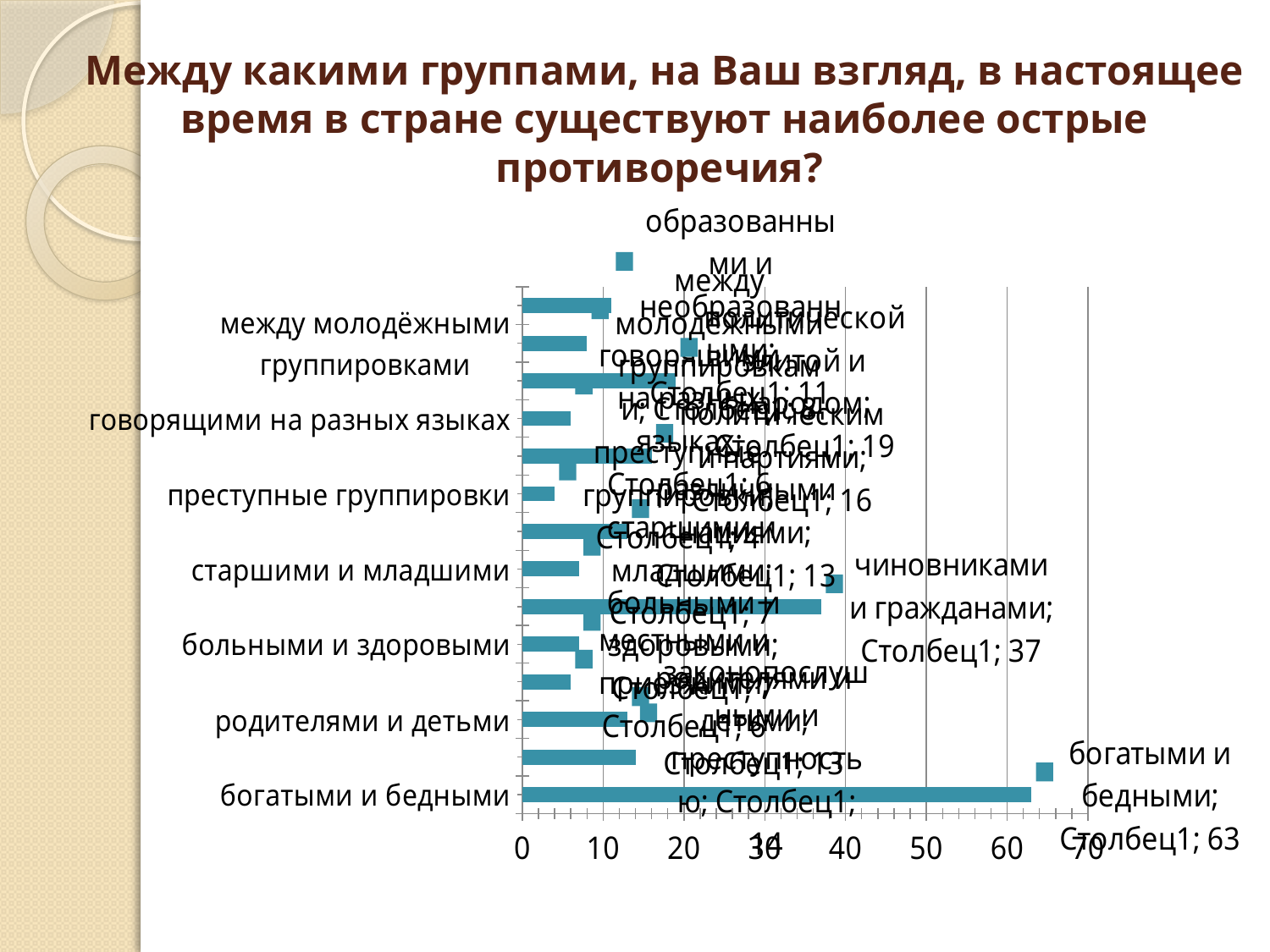
Which is larger: the value for 'богатыми и бедными' or for 'чиновниками и гражданами'? богатыми и бедными Is the value for 'богатыми и бедными' greater or less than 60? greater What is the name of the data series shown in the data labels? Столбец1 What is the value for 'богатыми и бедными'? 63 Is the value for 'преступные группировки' greater or less than 10? less What kind of chart is shown on the slide? bar chart Which is larger: the value for 'богатыми и бедными' or for 'родителями и детьми'? богатыми и бедными What is the highest value shown on the horizontal axis? 70 What is the value for 'чиновниками и гражданами'? 37 Which category has the highest value? богатыми и бедными Is the value for 'между молодёжными группировками' greater or less than 20? less What is the difference between the values for 'богатыми и бедными' and 'чиновниками и гражданами'? 26